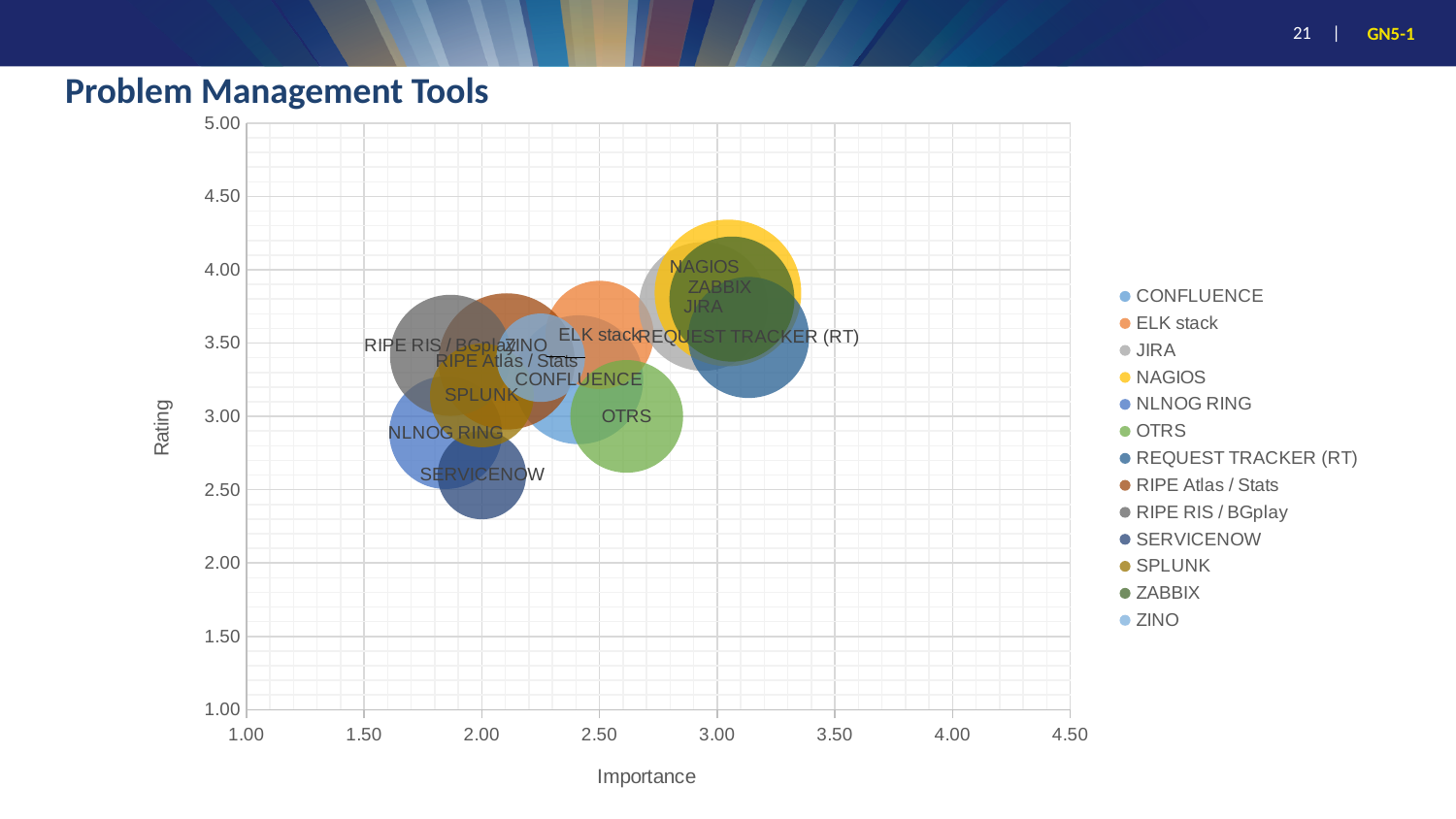
Is the Importance for RIPE RIS / BGplay greater or less than 2.50? less Is the Importance for REQUEST TRACKER (RT) greater or less than 2.50? greater What are the labels of the x axis and y axis of the chart? Importance (x axis) and Rating (y axis) Is the Rating for ZABBIX greater or less than 3.00? greater Which has the higher Rating, NAGIOS or SERVICENOW? NAGIOS What kind of chart is shown on the slide? Bubble chart How many entries does the chart legend list? 13 What is the title of the chart on the slide? Problem Management Tools Which tool has the highest Rating in the chart? NAGIOS Which has the higher Importance, OTRS or RIPE RIS / BGplay? OTRS Which tool has the lowest Rating in the chart? SERVICENOW